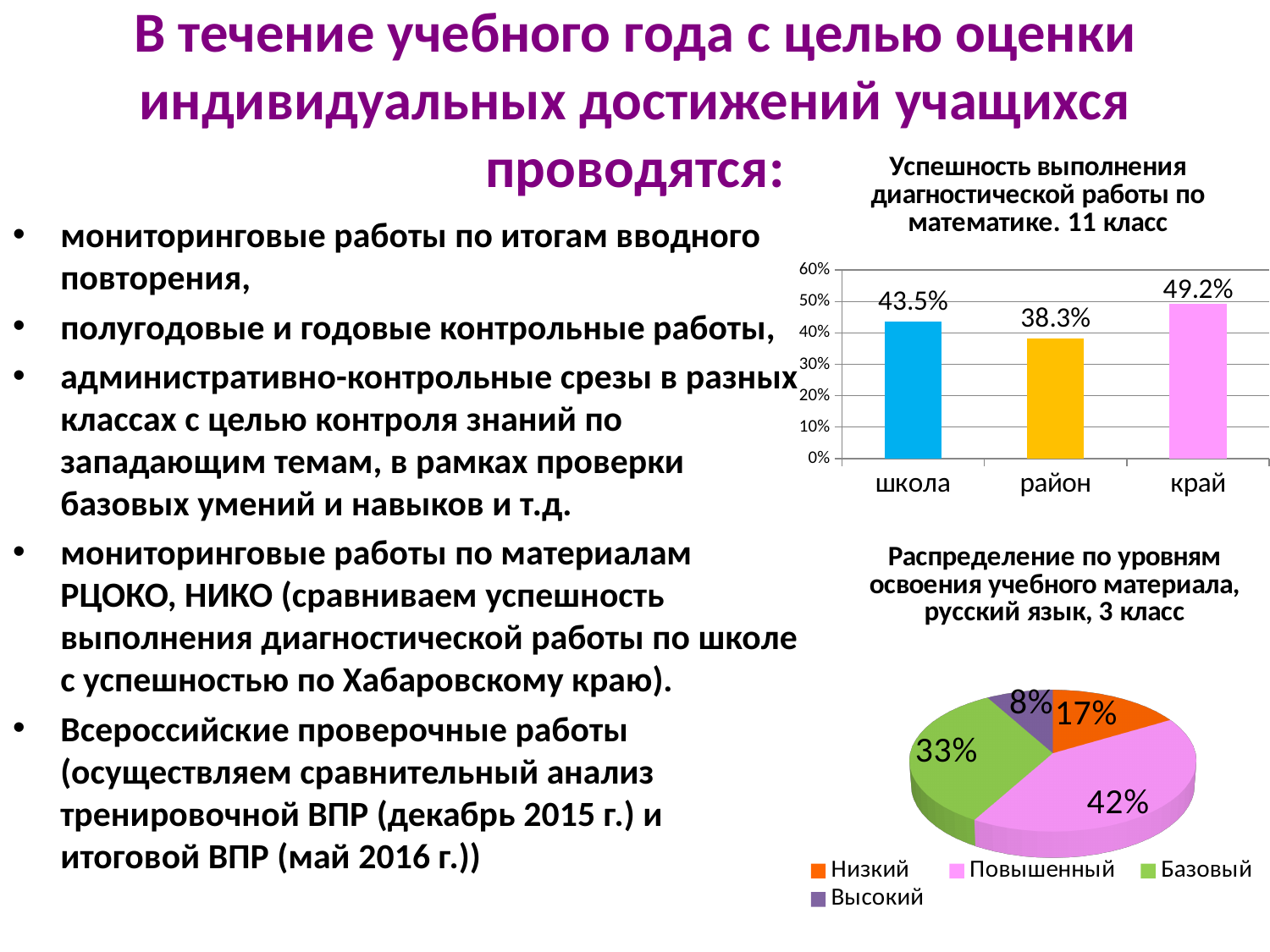
In the bar chart 'Успешность выполнения диагностической работы по математике. 11 класс', what is the value for район? 38.3% How many categories are shown in the bar chart 'Успешность выполнения диагностической работы по математике. 11 класс'? 3 In the bar chart 'Успешность выполнения диагностической работы по математике. 11 класс', which category has the lowest value? район In the bar chart 'Успешность выполнения диагностической работы по математике. 11 класс', what is the value for школа? 43.5% In the pie chart 'Распределение по уровням освоения учебного материала, русский язык, 3 класс', which is larger: Базовый or Низкий? Базовый In the pie chart 'Распределение по уровням освоения учебного материала, русский язык, 3 класс', which level has the smallest share? Высокий In the bar chart 'Успешность выполнения диагностической работы по математике. 11 класс', which category has the highest value? край In the pie chart 'Распределение по уровням освоения учебного материала, русский язык, 3 класс', what share does Повышенный have? 42% How many entries does the legend of the pie chart 'Распределение по уровням освоения учебного материала, русский язык, 3 класс' list? 4 In the bar chart 'Успешность выполнения диагностической работы по математике. 11 класс', is the value for район greater or less than 40%? less In the bar chart 'Успешность выполнения диагностической работы по математике. 11 класс', what is the difference between the values for край and школа? 5.7% What kind of chart is the upper chart on the right side of the slide? bar chart